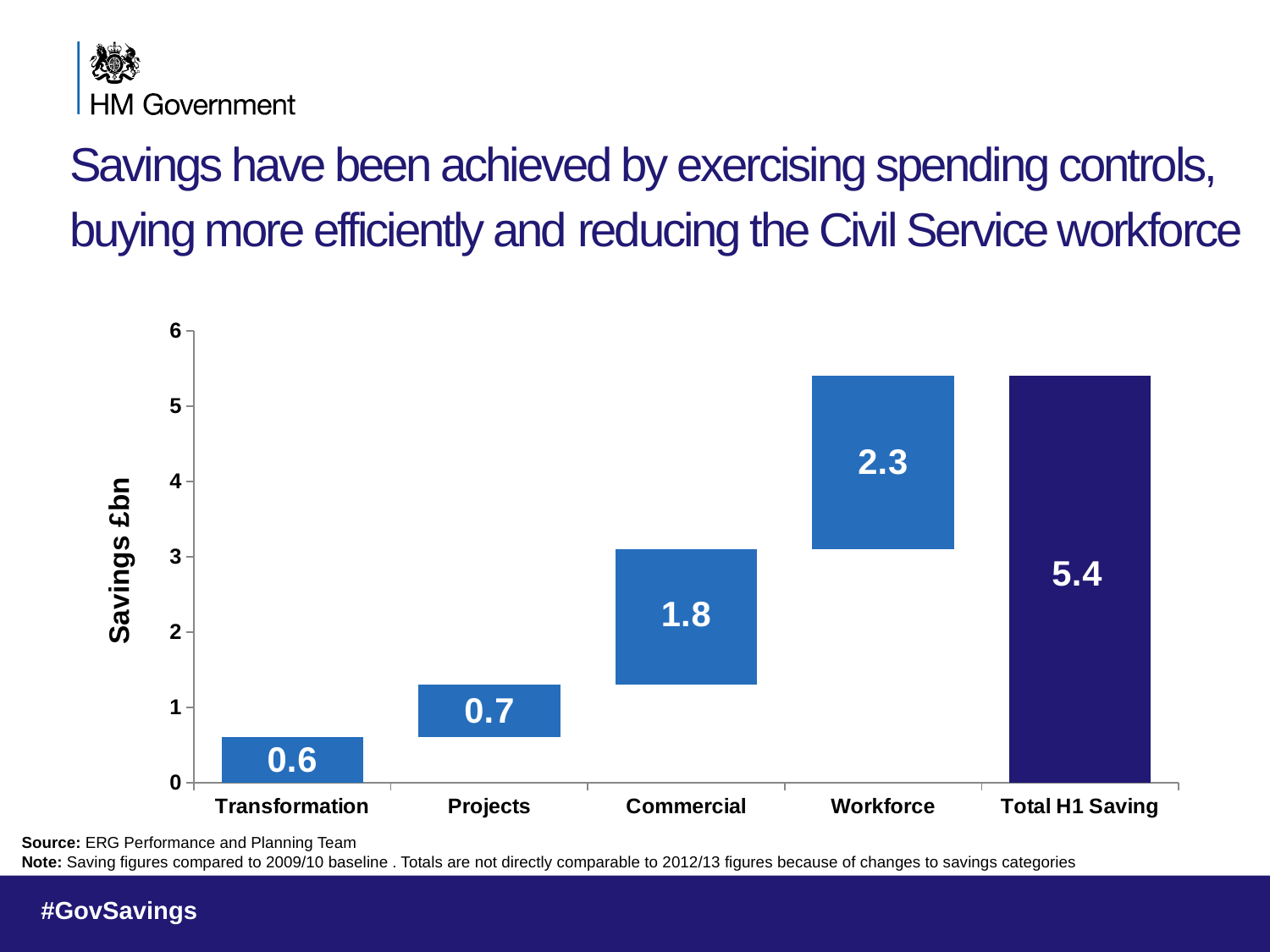
How many categories are shown on the x axis? 5 Which of the four savings categories (excluding the total) has the highest value? Workforce What is the value for Workforce? 2.3 What is the value for Transformation? 0.6 What is the difference between the Workforce and Commercial values? 0.5 What is the difference between the Projects and Transformation values? 0.1 Which category has the lowest value? Transformation What kind of chart is shown on the slide? Bar chart What is the value shown for Total H1 Saving? 5.4 What is the value for Commercial? 1.8 Which is larger, the value for Commercial or the value for Projects? Commercial What is the label of the y axis? Savings £bn